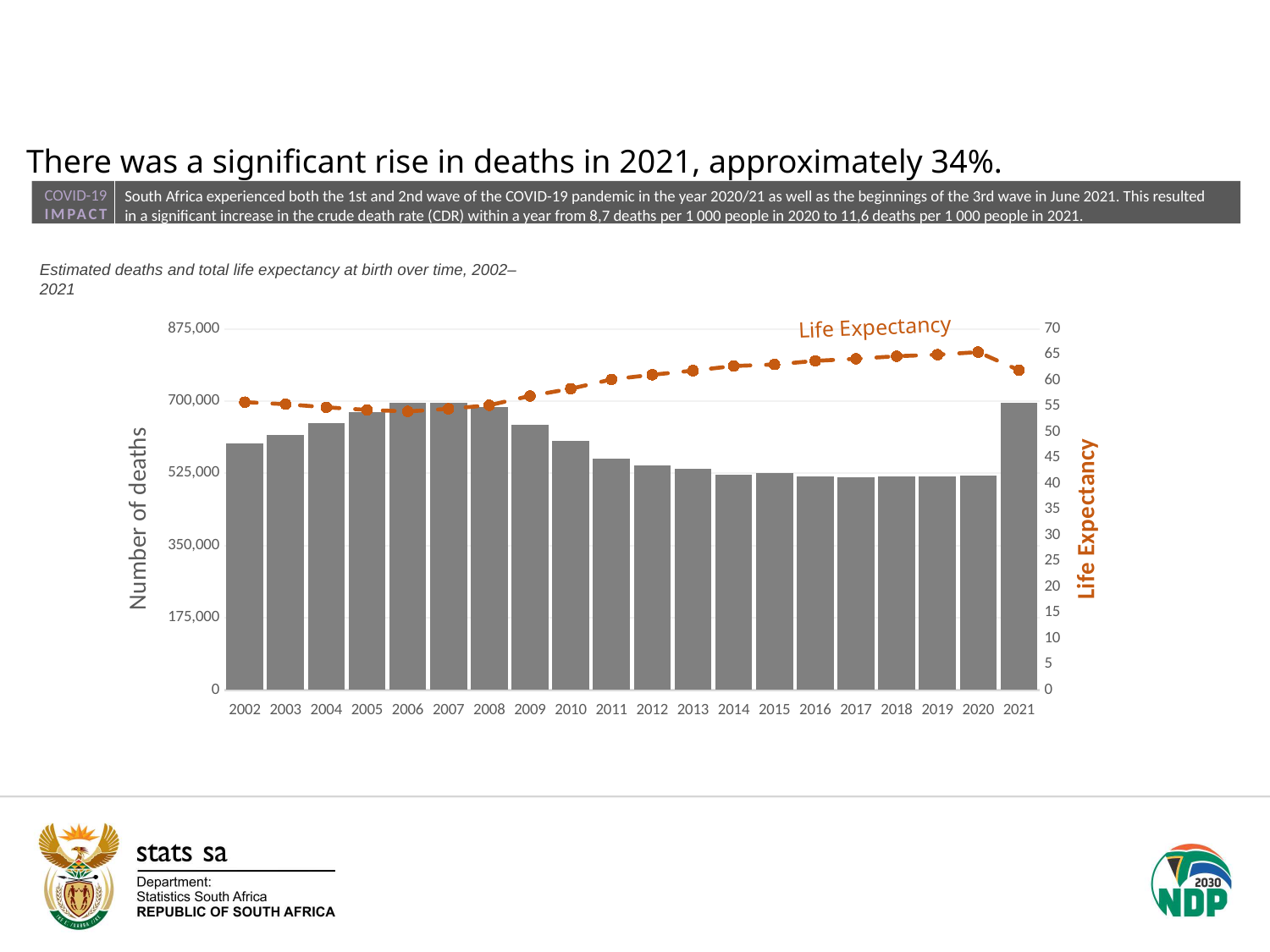
Does life expectancy rise or fall between 2009 and 2020? rise Does the number of deaths rise or fall between 2007 and 2016? fall Which year has a higher life expectancy, 2020 or 2021? 2020 What is the label of the left vertical axis of the chart? Number of deaths Is the number of deaths in 2021 greater or less than 525,000? greater Is the life expectancy in 2020 greater or less than 60? greater Is the life expectancy in 2002 greater or less than 60? less What kind of chart is shown on the slide? A combination bar and line chart Which year has more deaths, 2006 or 2012? 2006 How many years are shown along the x axis of the chart? 20